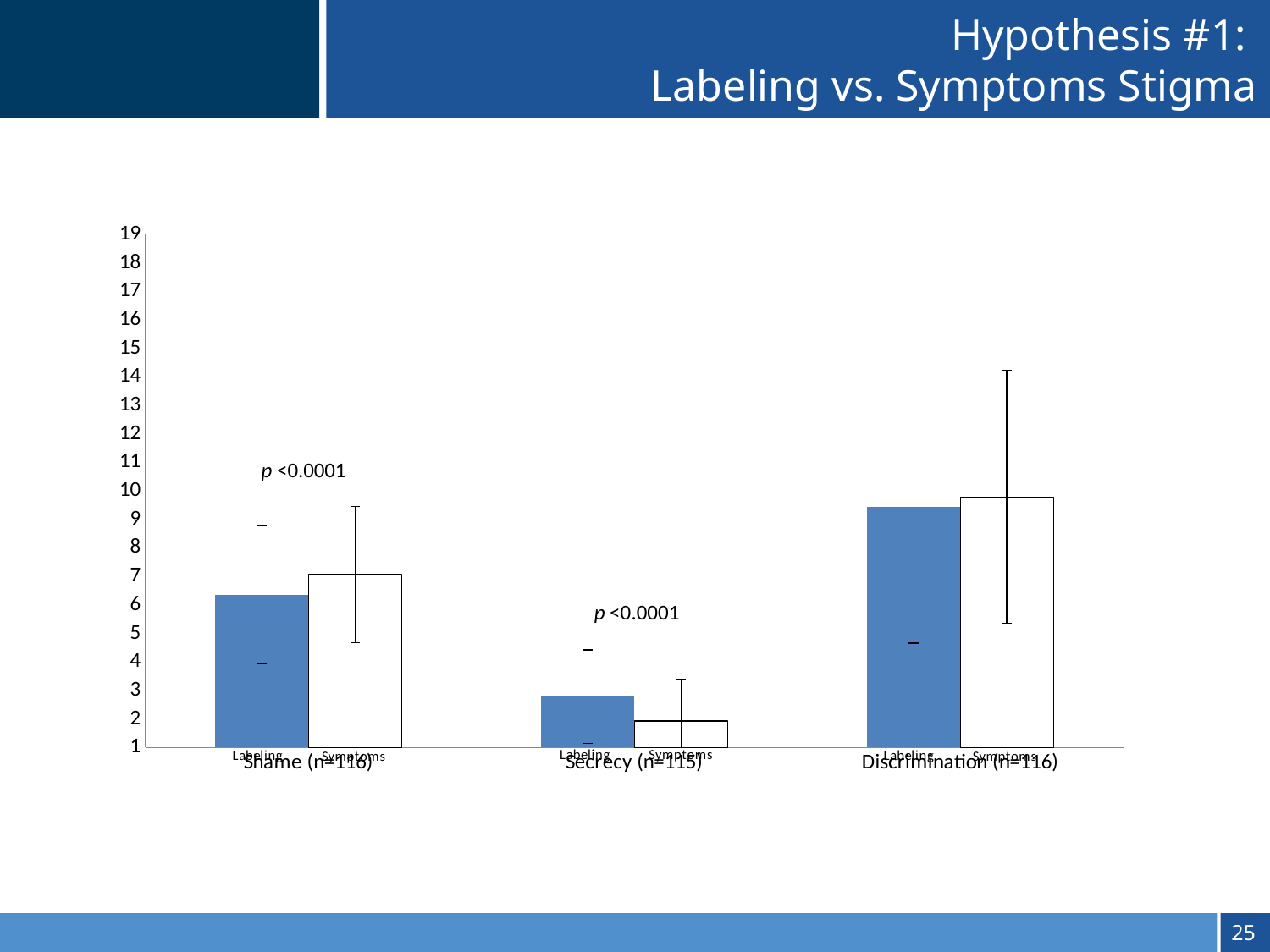
How many stigma categories (groups) are shown along the x axis? 3 Is the Symptoms bar for Secrecy (n=115) greater or less than 3? less Is the Labeling bar for Discrimination (n=116) greater or less than 8? greater What p-value is annotated above the Shame (n=116) bars? p <0.0001 What kind of chart is shown on the slide? bar chart Which stigma category has the tallest bars? Discrimination (n=116) Is the Labeling bar for Shame (n=116) greater or less than 5? greater For Secrecy (n=115), which bar is taller, Labeling or Symptoms? Labeling What is the sample size shown for the Secrecy category? n=115 How many bars are plotted for each stigma category? 2 Which stigma category has the shortest bars? Secrecy (n=115)